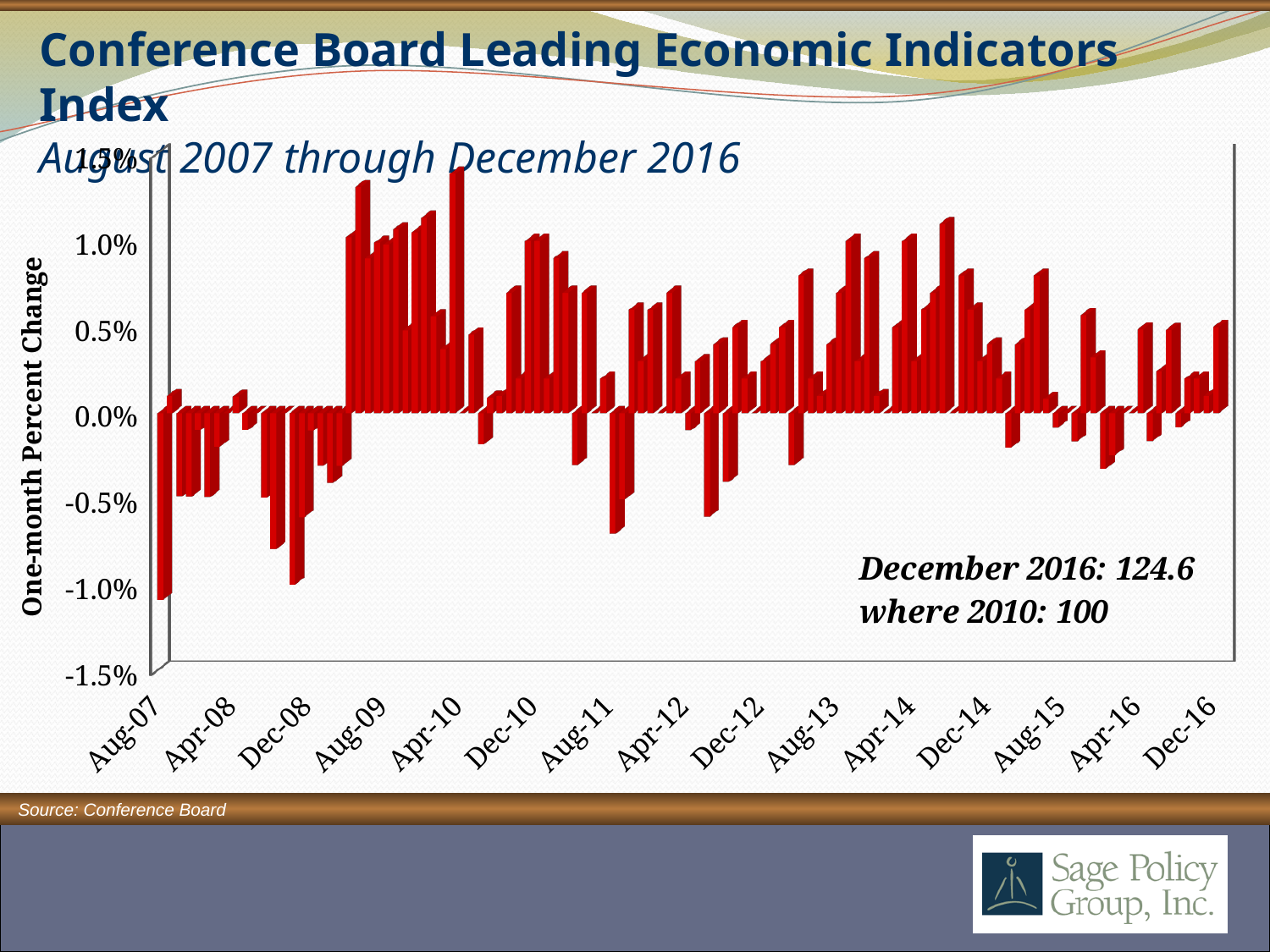
What is the highest tick value shown on the vertical axis? 1.5% What kind of chart is shown on the slide? Bar chart According to the annotation on the chart, what is the index value for December 2016? 124.6 What is the lowest tick value shown on the vertical axis? -1.5% What period does the chart cover, according to the subtitle? August 2007 through December 2016 Is the value for Dec-16 greater or less than 0.0%? greater Is the value for Aug-07 greater or less than 0.0%? less Is the value for Aug-07 greater or less than -0.5%? less Which is larger, the value for Aug-07 or the value for Dec-16? Dec-16 What is the title of the chart on the slide? Conference Board Leading Economic Indicators Index What is the label on the vertical axis of the chart? One-month Percent Change According to the annotation on the chart, what is the base year in which the index equals 100? 2010